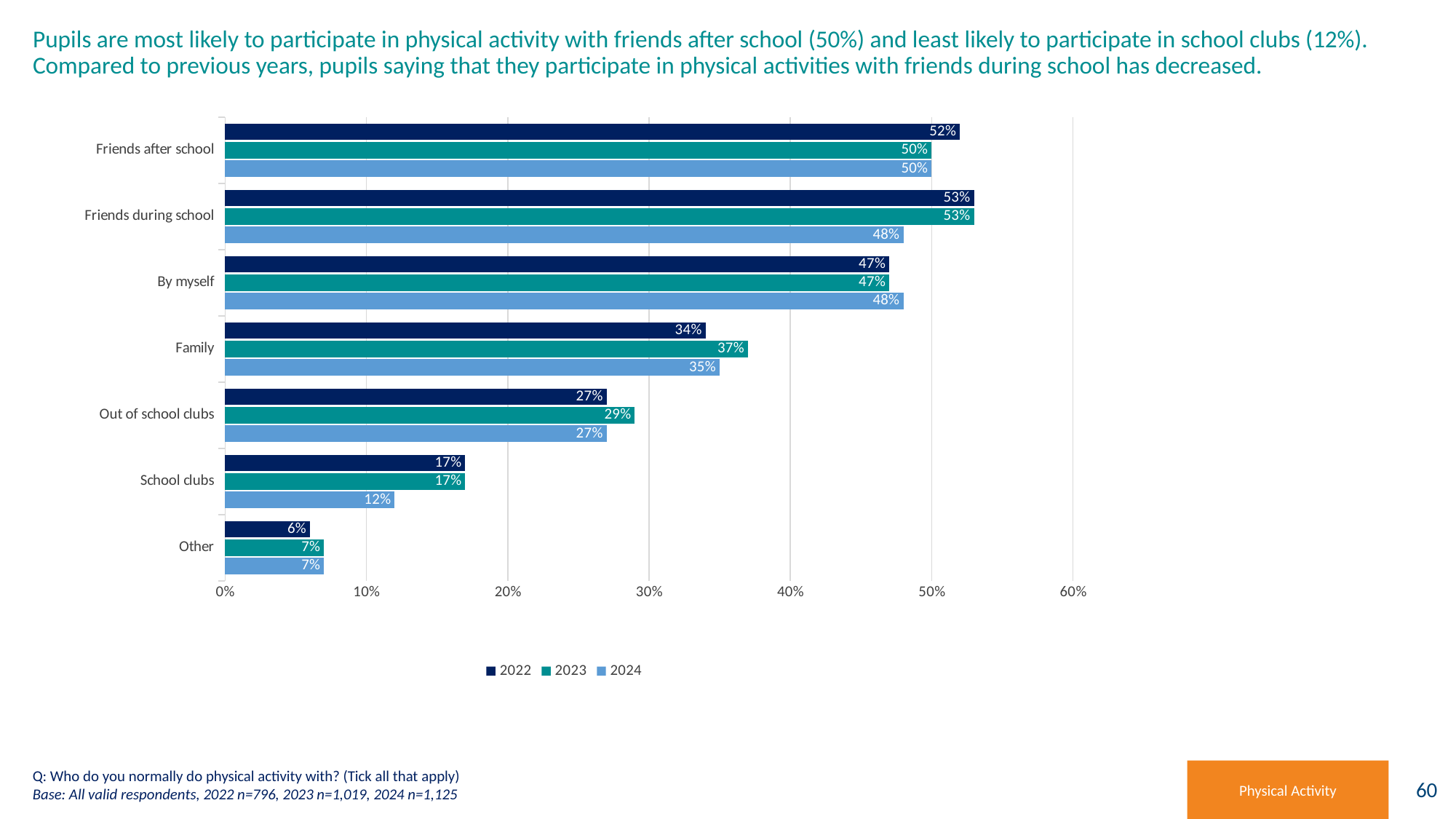
Which years are listed in the chart legend? 2022, 2023, 2024 Which is larger for 'Out of school clubs': the 2023 value or the 2024 value? 2023 What kind of chart is shown on the slide? Bar chart What percentage of pupils said they do physical activity with friends after school in 2024? 50% What is the 2022 value for 'Friends during school'? 53% How many series does the legend list? 3 What is the difference between the 2022 and 2024 values for 'Friends during school'? 5 percentage points Which category has the highest value for 2022? Friends during school What is the difference between the 2023 and 2024 values for 'School clubs'? 5 percentage points How many categories are shown on the chart? 7 Which category has the lowest value for 2024? Other What percentage of pupils said they do physical activity with family in 2023? 37%